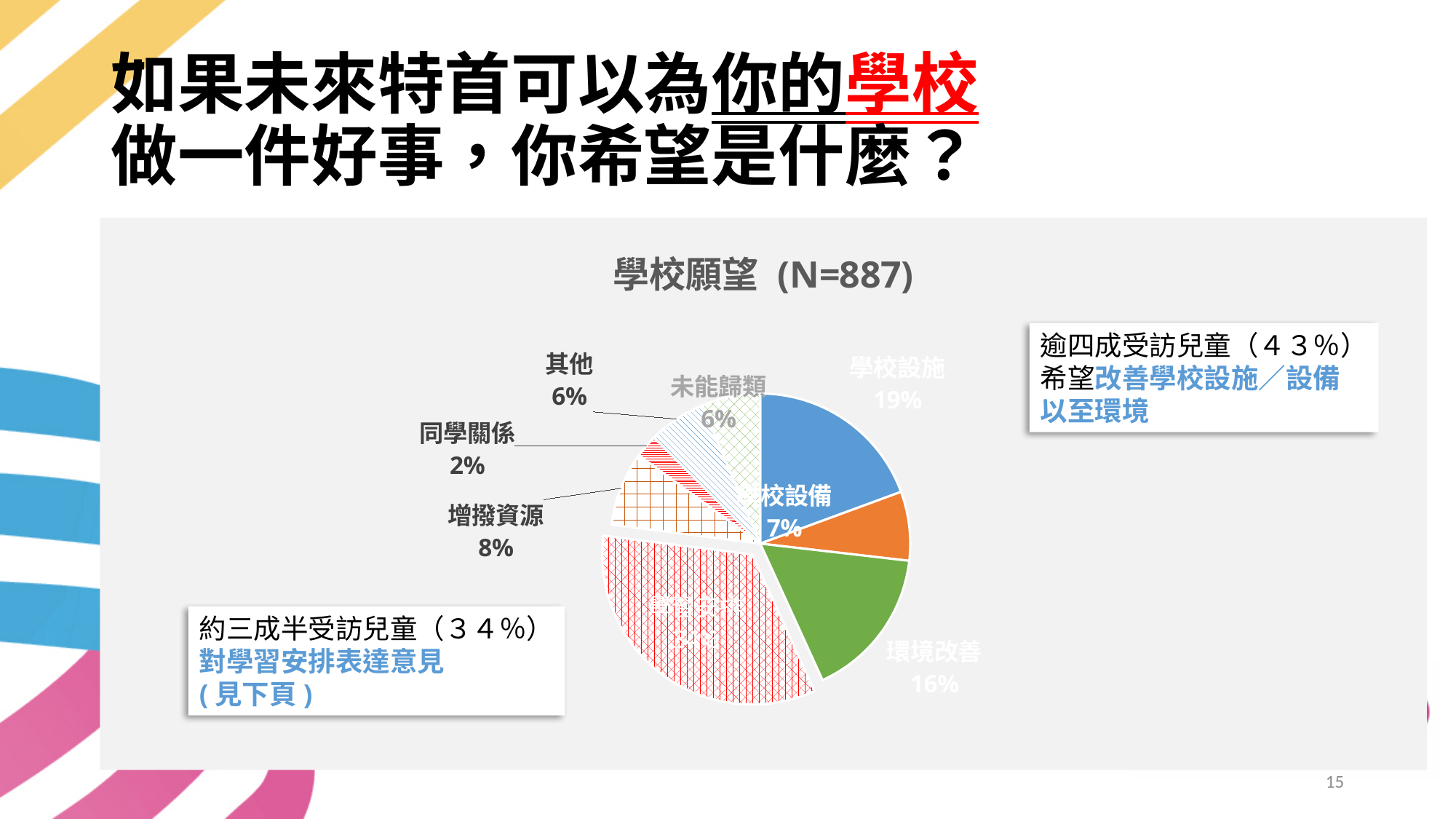
What percentage is shown for 環境改善 in the pie chart? 16% What percentage of the pie chart is the 學校設施 slice? 19% What is the title of the chart? 學校願望 (N=887) What share does 增撥資源 have in the pie chart? 8% How many slices does the pie chart have? 8 By how many percentage points does 學校設施 exceed 環境改善? 3% What percentage is labelled for 同學關係? 2% What type of chart is shown on the slide? Pie chart Which is larger, the 學校設施 slice or the 環境改善 slice? 學校設施 What percentage is shown for 學校設備? 7% Which labelled slice of the pie chart has the smallest share? 同學關係 What percentage is shown for 其他 in the pie chart? 6%